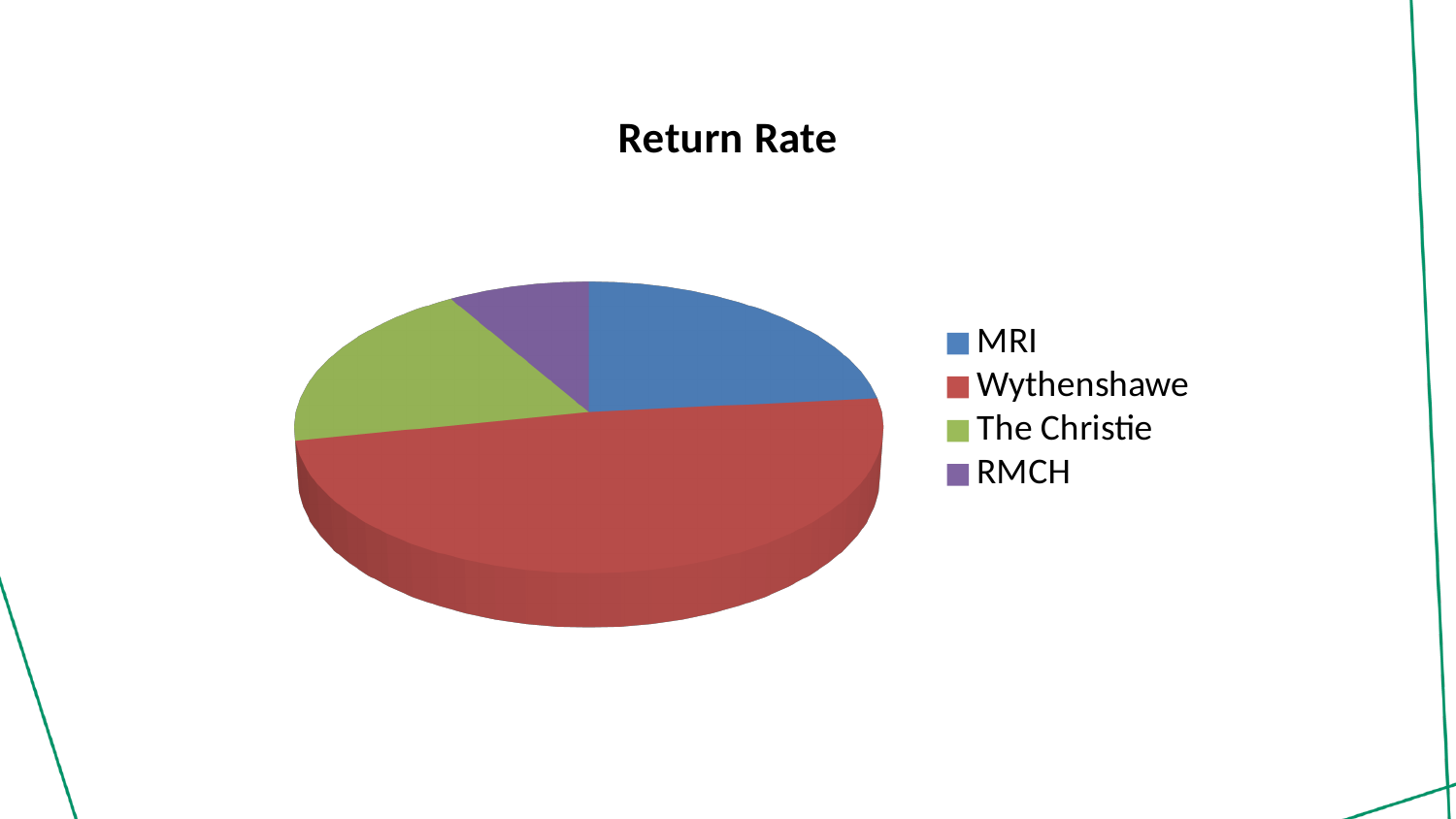
Which has the larger slice, The Christie or RMCH? The Christie What kind of chart is shown on the slide? pie chart Which has the larger slice, Wythenshawe or The Christie? Wythenshawe Which category has the largest slice of the pie? Wythenshawe How many categories does the pie chart have? 4 Which has the larger slice, MRI or RMCH? MRI Which colour represents Wythenshawe in the legend? red Which category has the smallest slice of the pie? RMCH What is the title of the chart? Return Rate